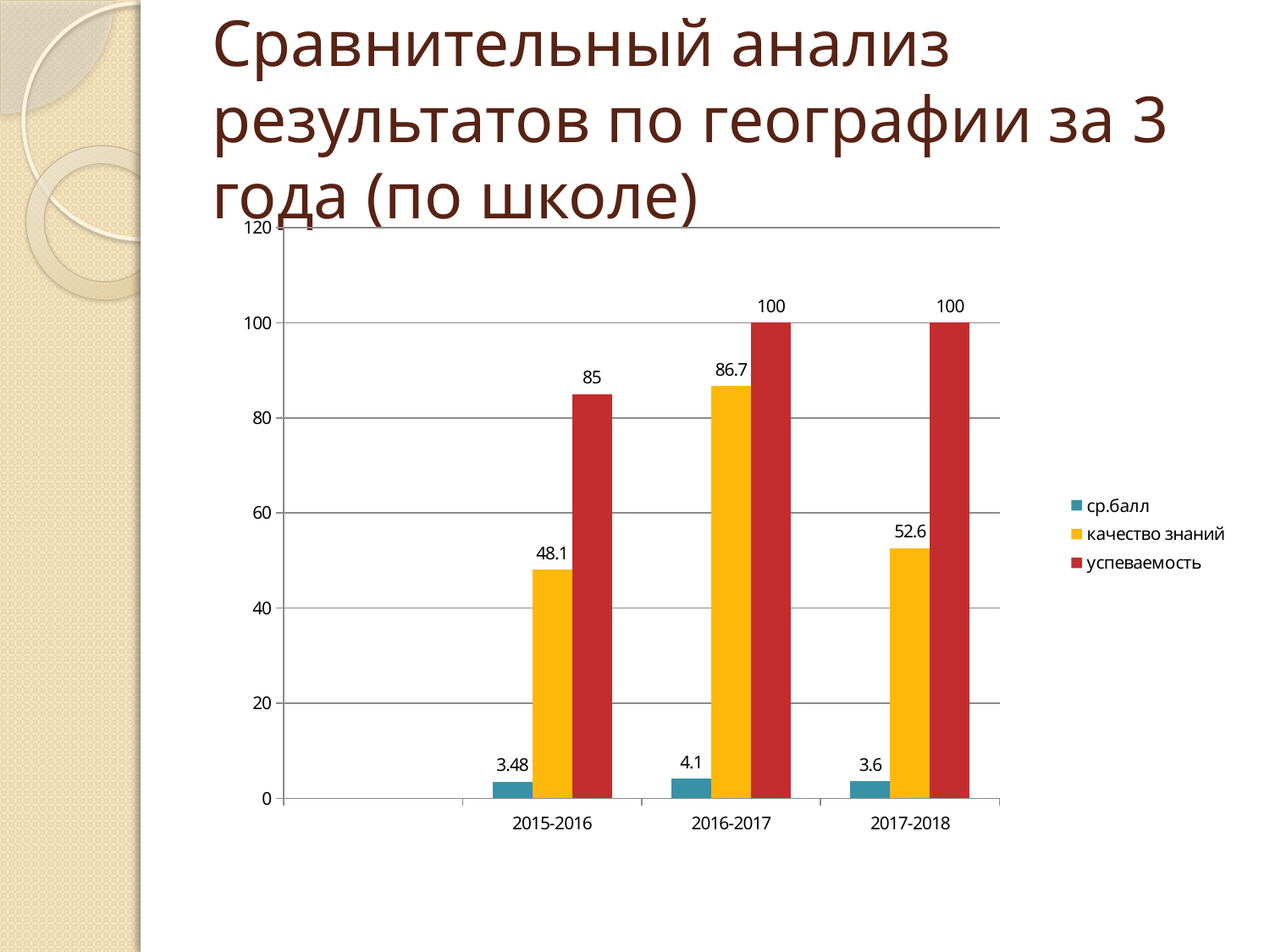
What kind of chart is shown on the slide? bar chart How many series does the legend list? 3 What is the difference between качество знаний in 2016-2017 and in 2015-2016? 38.6 Which is larger: качество знаний in 2017-2018 or in 2015-2016? 2017-2018 In which year is ср.балл lowest? 2015-2016 What is the value of качество знаний for 2017-2018? 52.6 Which series is shown in red? успеваемость What is the value of качество знаний for 2016-2017? 86.7 What is the value of ср.балл for 2015-2016? 3.48 How many year categories are shown on the x axis? 3 In which year is качество знаний highest? 2016-2017 What is the value of успеваемость for 2015-2016? 85